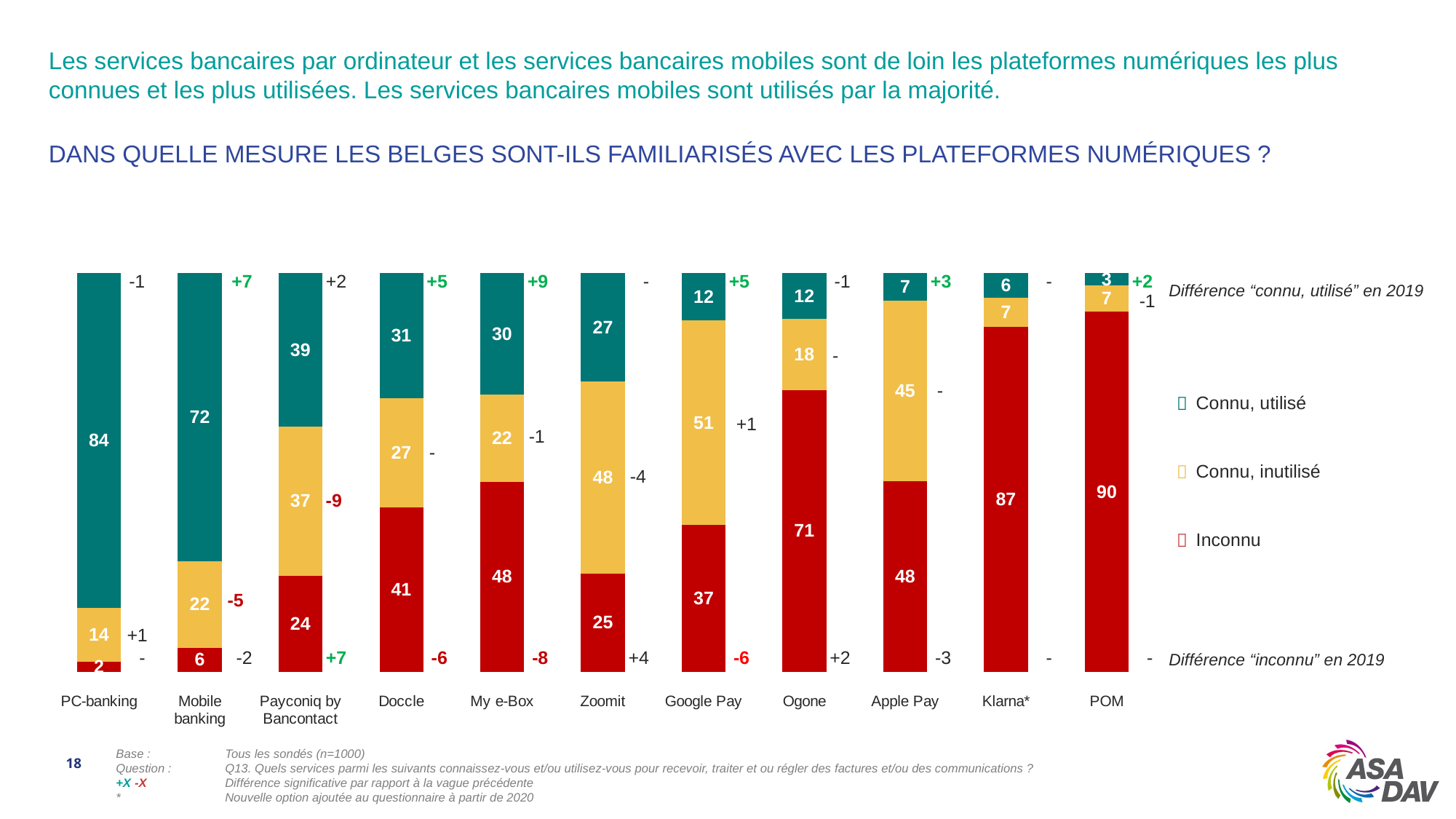
How many platforms (categories) are shown on the x axis? 11 What is the difference between the "Connu, utilisé" values for PC-banking and Mobile banking? 12 What is the "Connu, inutilisé" value for Google Pay? 51 Which platform has the lowest "Connu, utilisé" value? POM Which platform has the highest "Inconnu" value? POM What is the total of the stacked bar for Doccle? 99 Which is larger: the "Connu, inutilisé" value for Zoomit or for Apple Pay? Zoomit What is the "Connu, utilisé" value for PC-banking? 84 What kind of chart is shown on the slide? stacked bar chart What is the "Inconnu" value for Ogone? 71 How many series does the legend list? 3 Which series is shown in red in the legend? Inconnu